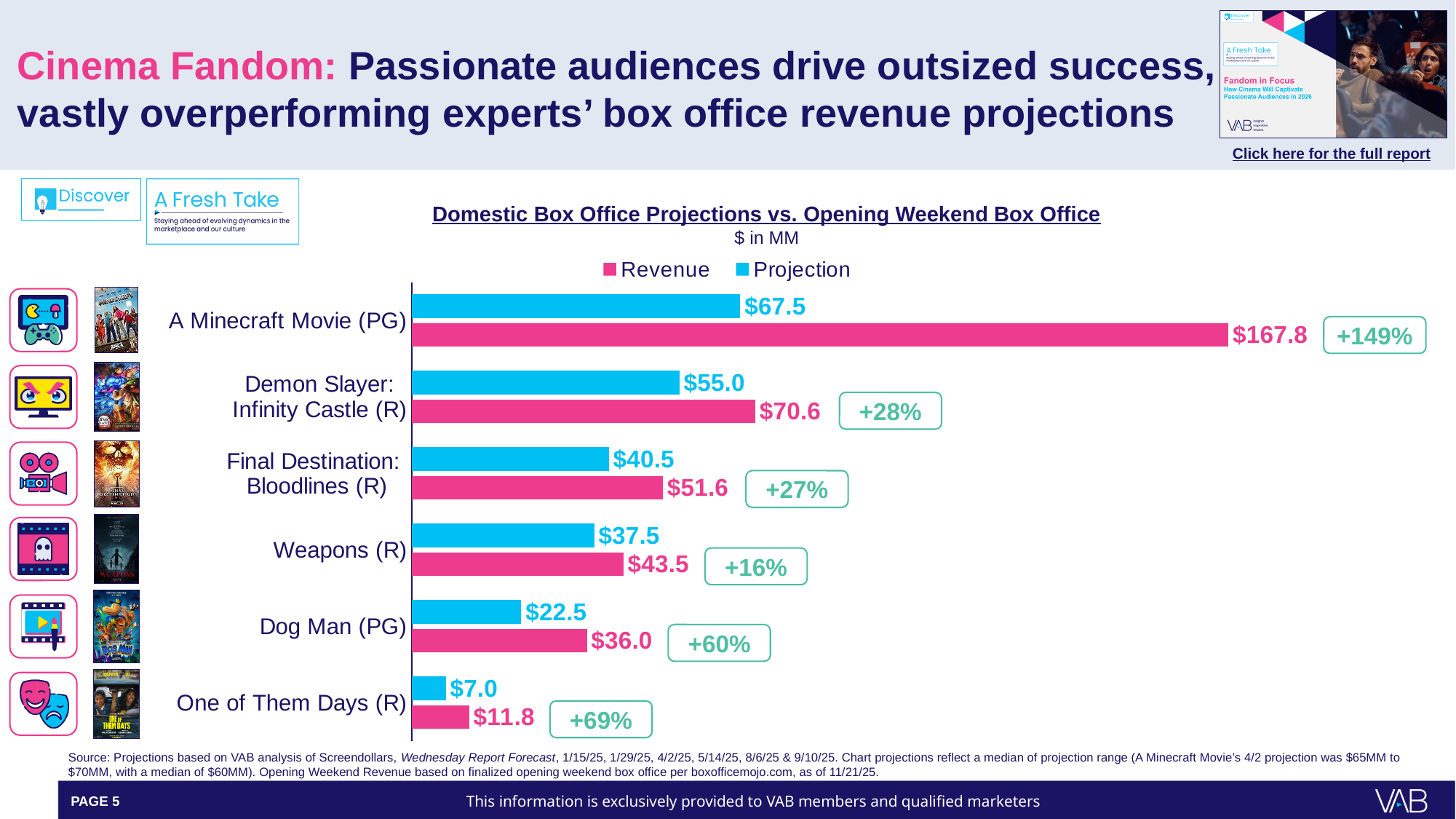
What is the difference between the Revenue and Projection values for Weapons (R)? $6.0 Which movie has the highest Revenue value? A Minecraft Movie (PG) What kind of chart is shown on the slide? Bar chart How many movies are shown on the chart? 6 Which movie has the lowest Projection value? One of Them Days (R) What is the Revenue value for Dog Man (PG)? $36.0 What is the Projection value for Demon Slayer: Infinity Castle (R)? $55.0 What colour are the Projection bars? Blue What is the title of the chart? Domestic Box Office Projections vs. Opening Weekend Box Office Which is larger for Final Destination: Bloodlines (R), the Revenue or the Projection? Revenue What is the Revenue value for A Minecraft Movie (PG)? $167.8 How many series does the legend list? 2